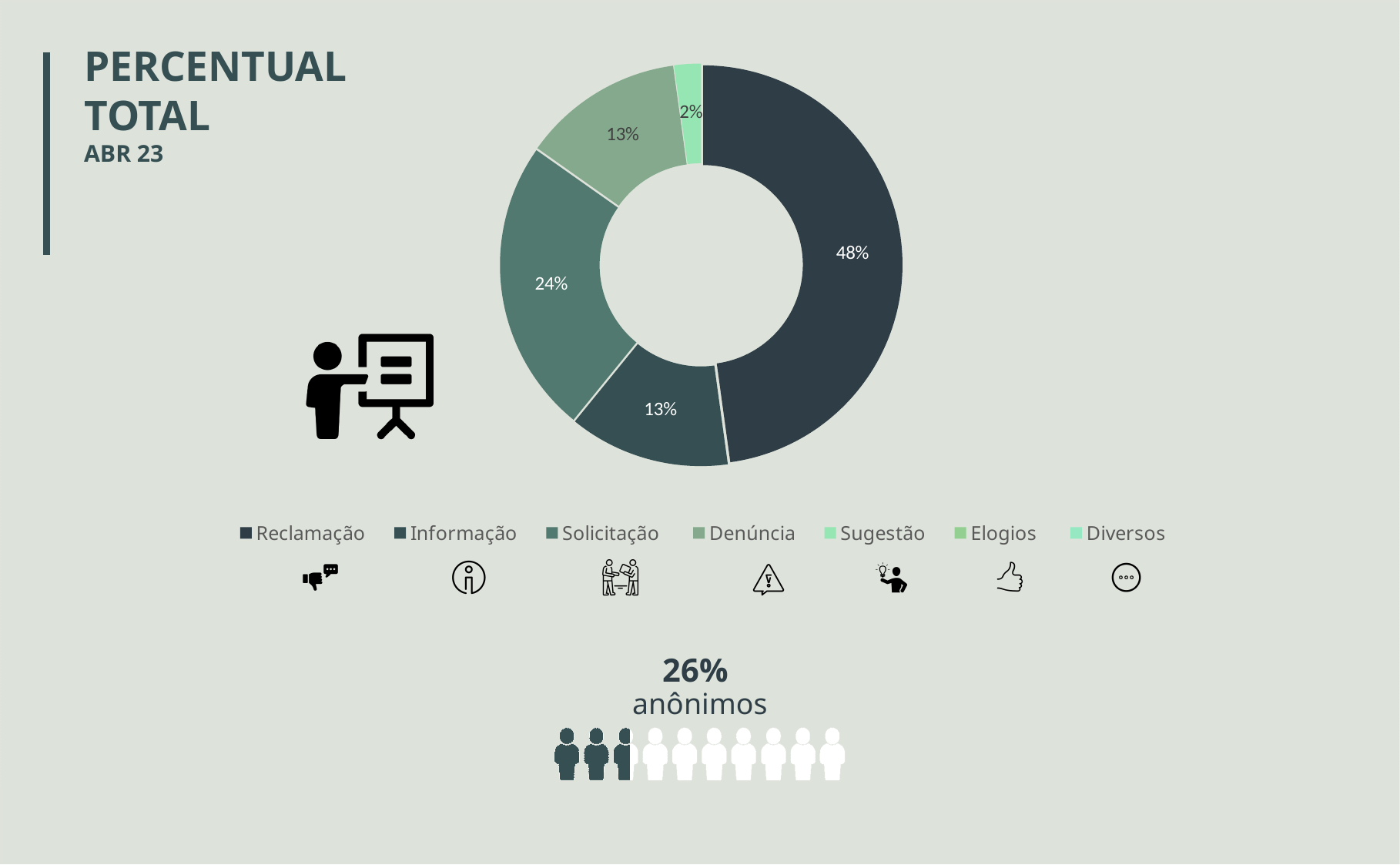
What kind of chart is shown on the slide? pie chart (donut) What is the smallest percentage labelled on the pie chart? 2% What percentage does the Reclamação slice show? 48% How many slices have a percentage label printed on the pie chart? 5 What percentage does the Solicitação slice show? 24% Which slice is larger, Solicitação or Informação? Solicitação Which category has the largest slice of the pie? Reclamação What is the difference in percentage points between the Reclamação slice and the Solicitação slice? 24 percentage points What percentage does the Denúncia slice show? 13% What is the title of the chart and which month does it refer to? PERCENTUAL TOTAL, ABR 23 What percentage does the Informação slice show? 13% How many categories are listed in the legend? 7